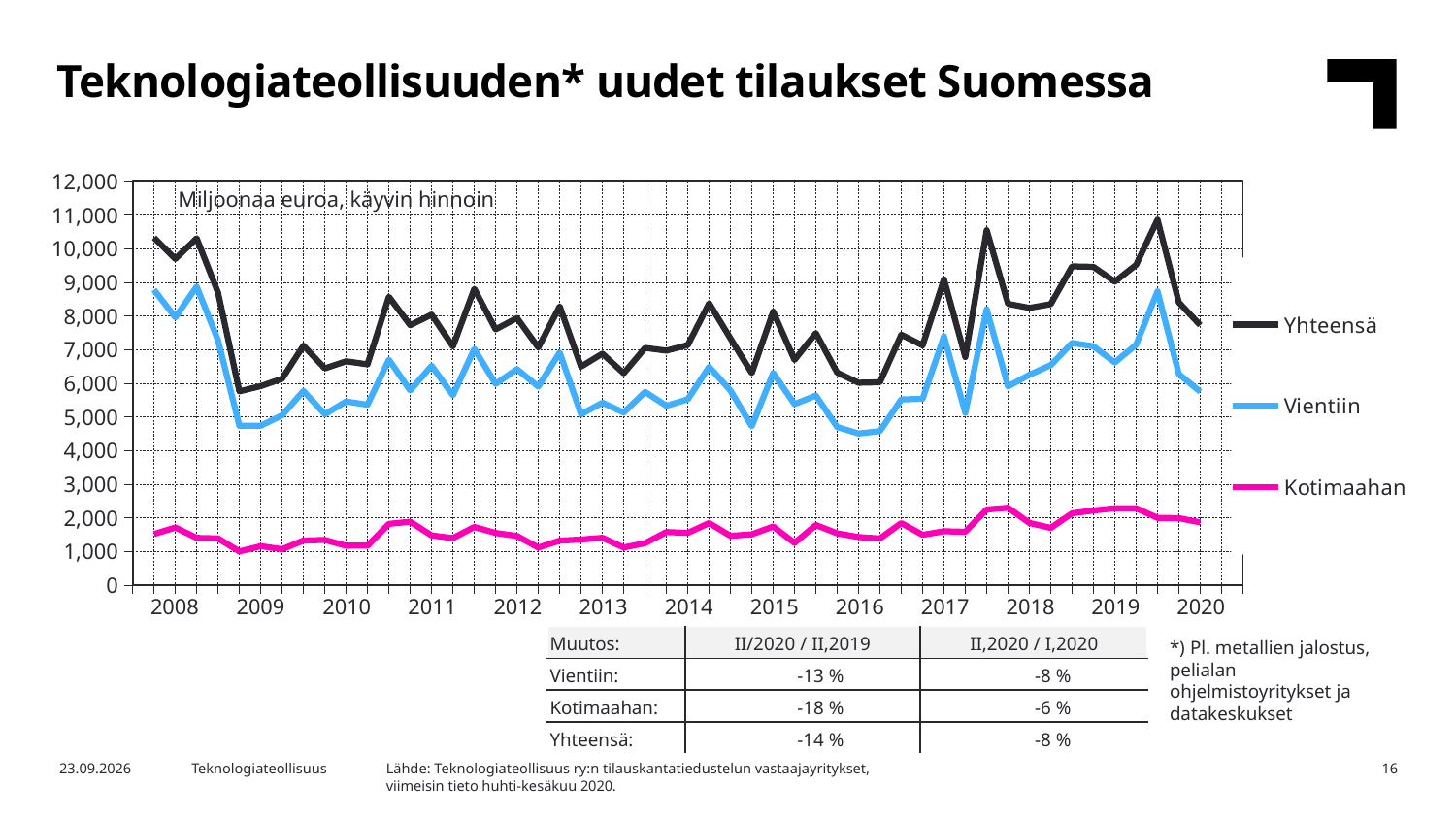
Which series is plotted with the pink line? Kotimaahan Which series has the highest values throughout the chart? Yhteensä In 2020, which is larger, Vientiin or Kotimaahan? Vientiin Is the peak value for Yhteensä in 2019 greater or less than 10,000? greater Is the value for Kotimaahan in 2020 greater or less than 3,000? less What unit note is printed inside the chart area? Miljoonaa euroa, käyvin hinnoin What kind of chart is shown on the slide? line chart How many series does the chart legend list? 3 Is the last plotted value for Vientiin in 2020 greater or less than 7,000? less Which series has the lowest values throughout the chart? Kotimaahan Do the Yhteensä values rise or fall from the 2019 peak to the end of 2020? fall